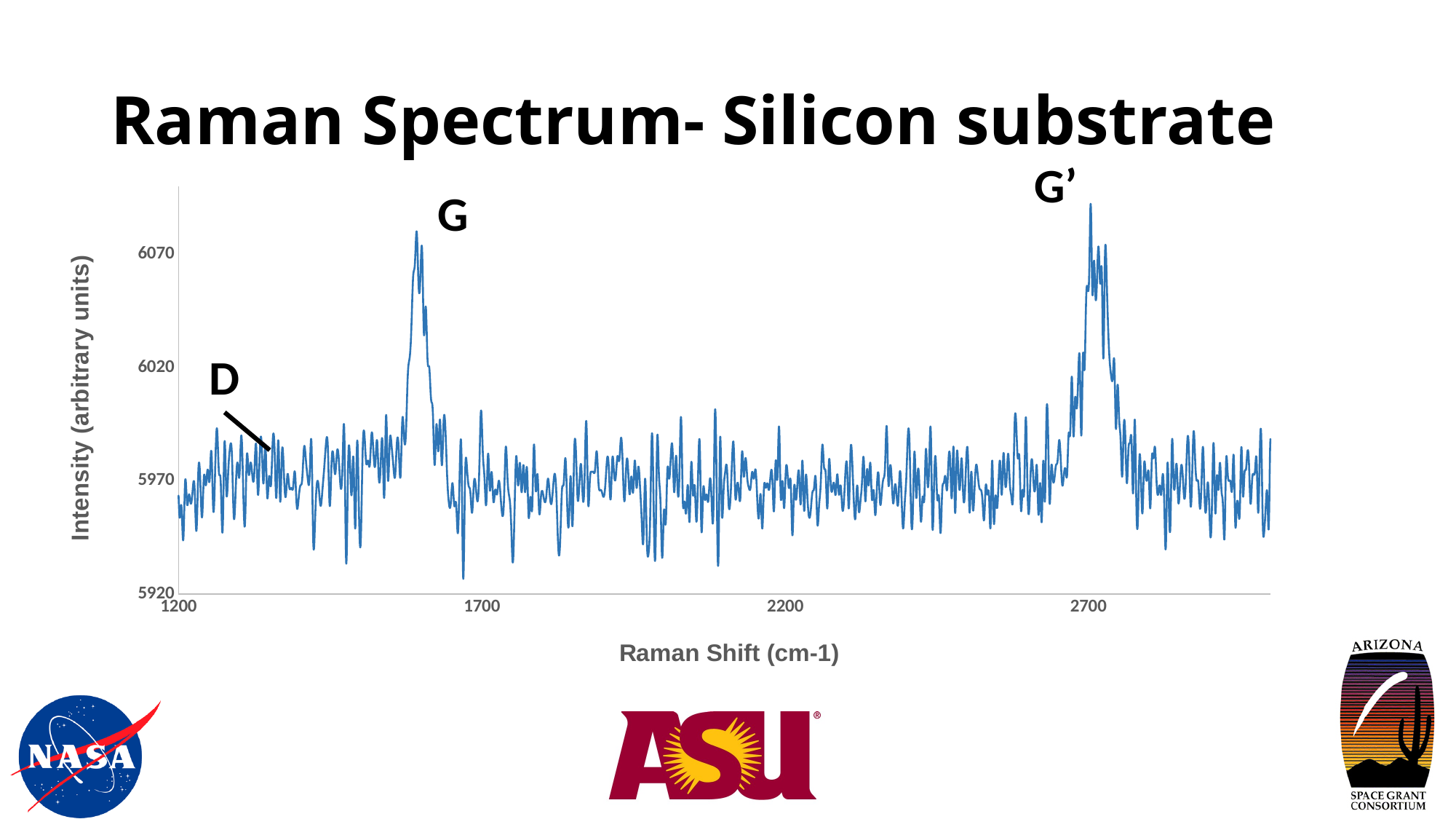
Is the intensity at the G' peak larger than the intensity at the D peak? yes What is the label of the x axis? Raman Shift (cm-1) How many data series are plotted on the chart? 1 How many labeled peaks are marked on the spectrum? 3 What kind of chart is shown on the slide? line chart What is the title of the chart? Raman Spectrum- Silicon substrate Is the intensity at the G peak greater or less than the intensity at the D peak? greater Is the intensity of the spectrum around a Raman shift of 2200 greater or less than 6020? less Which labeled peak (D, G or G') has the lowest intensity? D Is the intensity at the G' peak greater or less than 6070? greater Is the intensity at the D peak greater or less than 6020? less